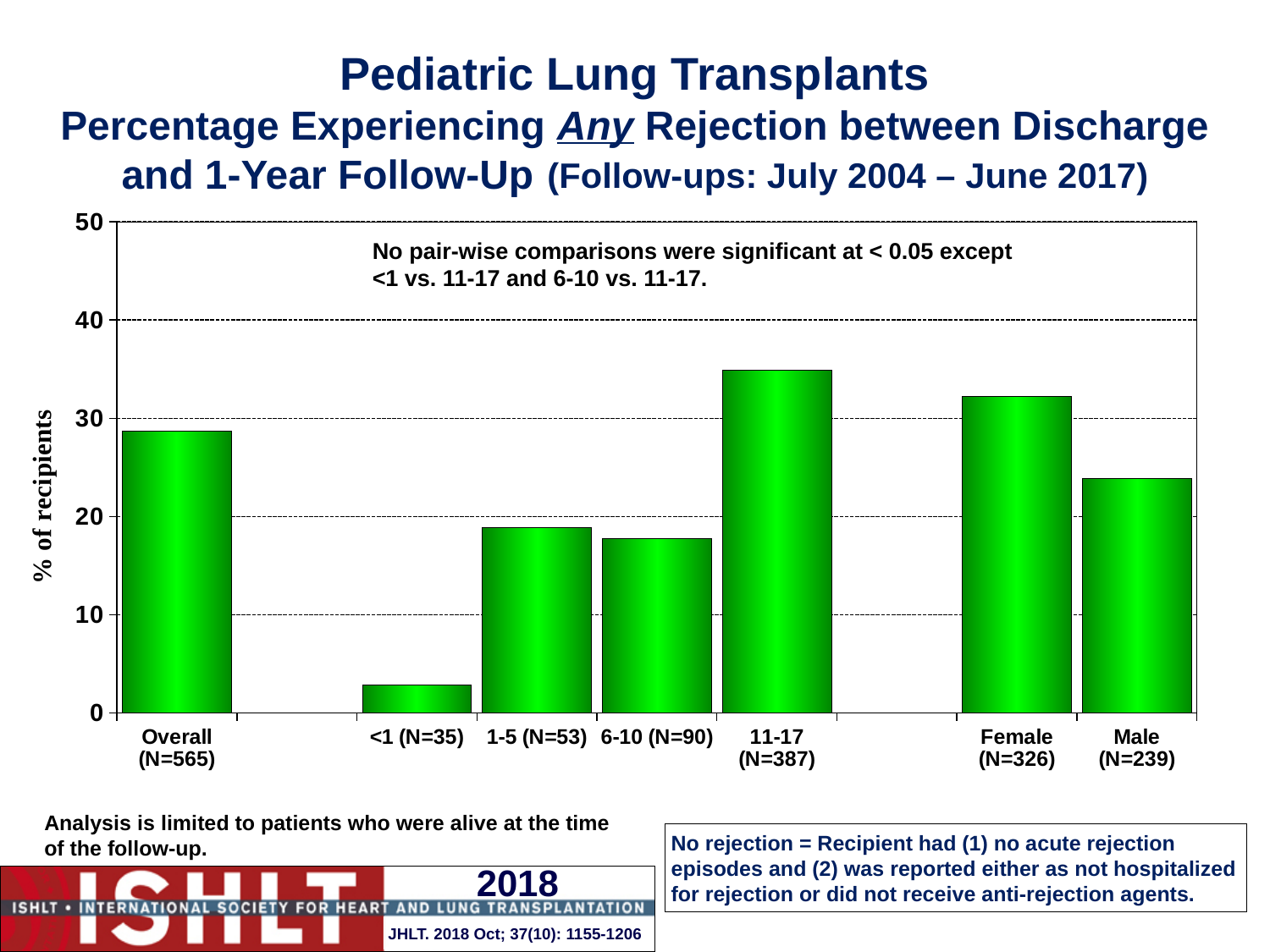
Which has a higher percentage of recipients experiencing rejection, Female or Male? Female Is the value for the <1 (N=35) group greater or less than 10? less Which has a higher percentage, the 11-17 age group or the Overall group? 11-17 Is the value for the 11-17 (N=387) group greater or less than 30? greater What kind of chart is shown on the slide? Bar chart Which category has the highest percentage of recipients experiencing any rejection? 11-17 (N=387) Is the value for the Male (N=239) group greater or less than 20? greater What is the label of the y-axis? % of recipients Which category has the lowest percentage of recipients experiencing any rejection? <1 (N=35) How many bars (categories) are plotted in the chart? 7